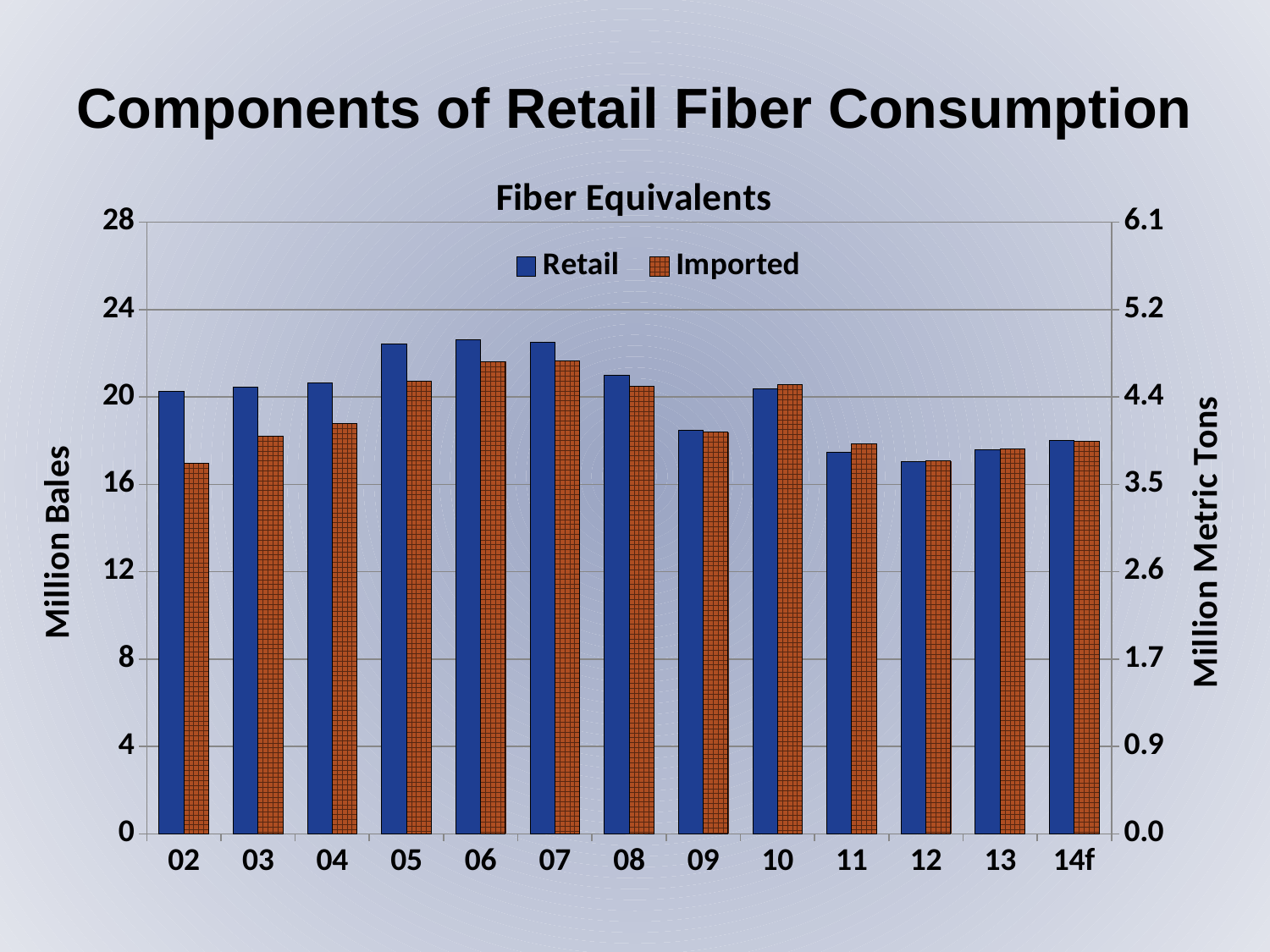
How many series does the legend list? 2 Is the Imported value for 02 greater or less than 20 million bales? less Is the Retail value for 05 greater or less than 20 million bales? greater Is the Retail value for 12 greater or less than 16 million bales? greater How many years are shown on the x axis? 13 What is the title of the left vertical axis? Million Bales Do the Retail values rise or fall from 07 to 09? fall In 04, which is larger, Retail or Imported? Retail In 02, which is larger, Retail or Imported? Retail What kind of chart is shown on the slide? bar chart